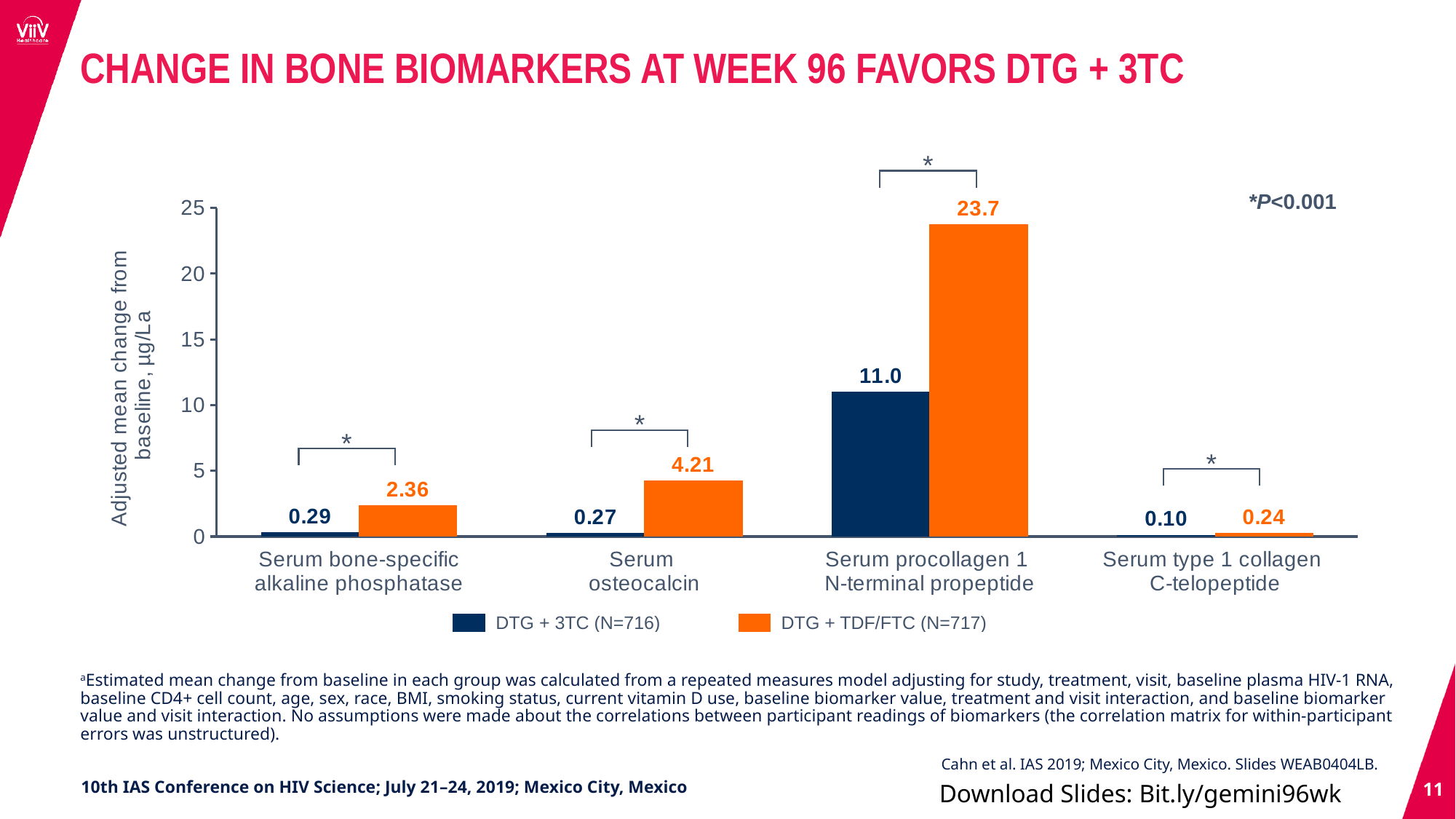
What is the value for DTG + 3TC in serum type 1 collagen C-telopeptide? 0.10 What is the adjusted mean change from baseline for DTG + TDF/FTC in serum osteocalcin? 4.21 What is the value for DTG + TDF/FTC in serum bone-specific alkaline phosphatase? 2.36 What is the adjusted mean change from baseline for DTG + 3TC in serum procollagen 1 N-terminal propeptide? 11.0 Is the DTG + TDF/FTC value for serum procollagen 1 N-terminal propeptide greater or less than 20? greater How many biomarker categories are shown on the x axis? 4 Which biomarker has the highest value for DTG + TDF/FTC? Serum procollagen 1 N-terminal propeptide What kind of chart is shown on the slide? Bar chart How many series does the legend list? 2 Which biomarker has the lowest value for DTG + 3TC? Serum type 1 collagen C-telopeptide What is the difference between the DTG + TDF/FTC and DTG + 3TC values for serum procollagen 1 N-terminal propeptide? 12.7 Which group has the larger value for serum osteocalcin, DTG + 3TC or DTG + TDF/FTC? DTG + TDF/FTC